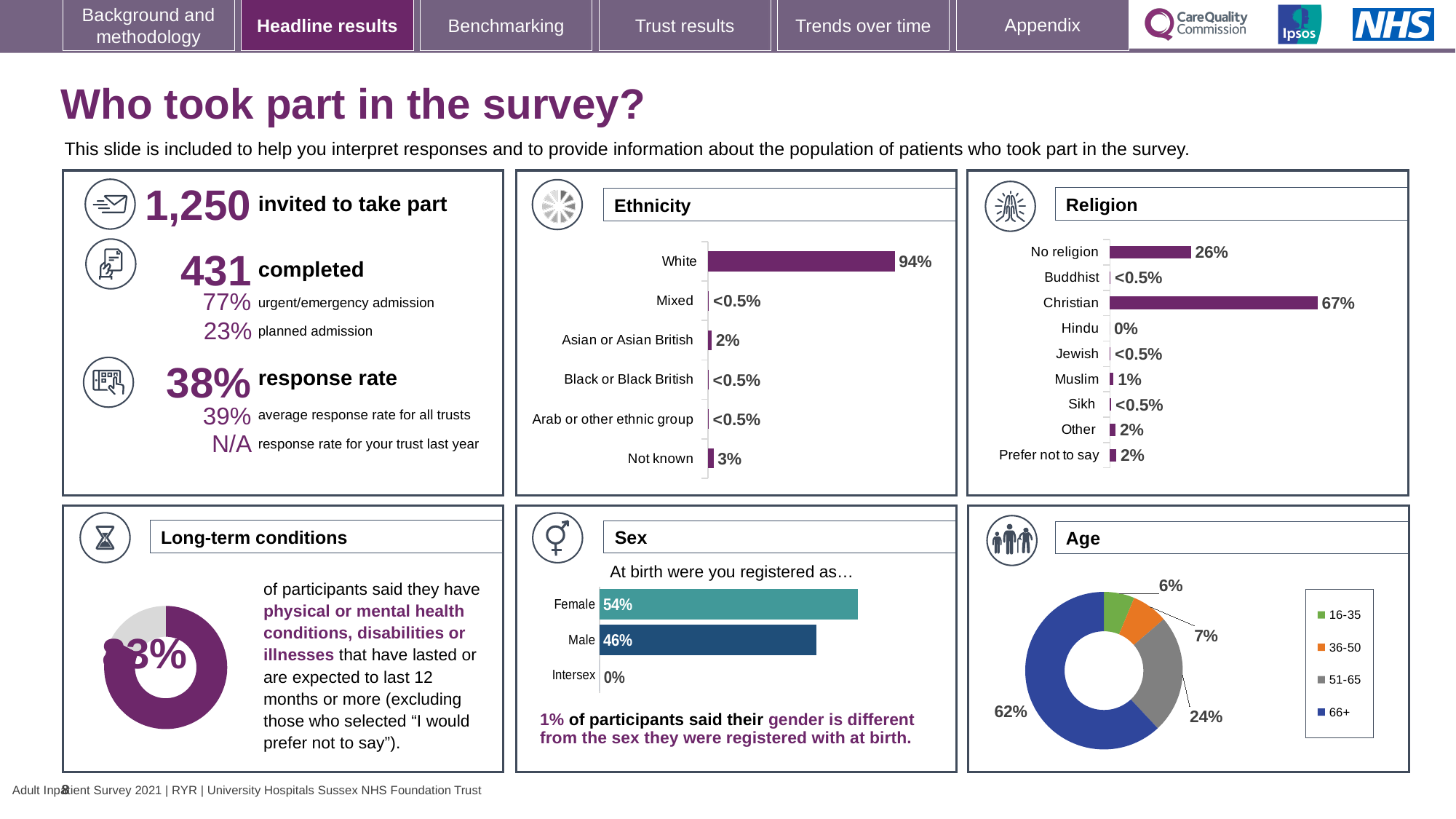
In the Religion chart, what is the value for No religion? 26% In the Age chart, what share of participants were aged 66+? 62% In the Ethnicity chart, what percentage of participants were White? 94% In the Religion chart, what is the difference between the Christian and No religion values? 41% In the Sex chart, which is larger, Female or Male? Female In the Age chart, how many age groups does the legend list? 4 In the Ethnicity chart, what is the value for Not known? 3% What type of chart is the Age chart? Donut (pie) chart In the Sex chart, what percentage of participants were registered as Female at birth? 54% In the Religion chart, what is the value for Hindu? 0% In the Religion chart, which religion category has the highest value? Christian In the Ethnicity chart, how many ethnic categories are listed? 6